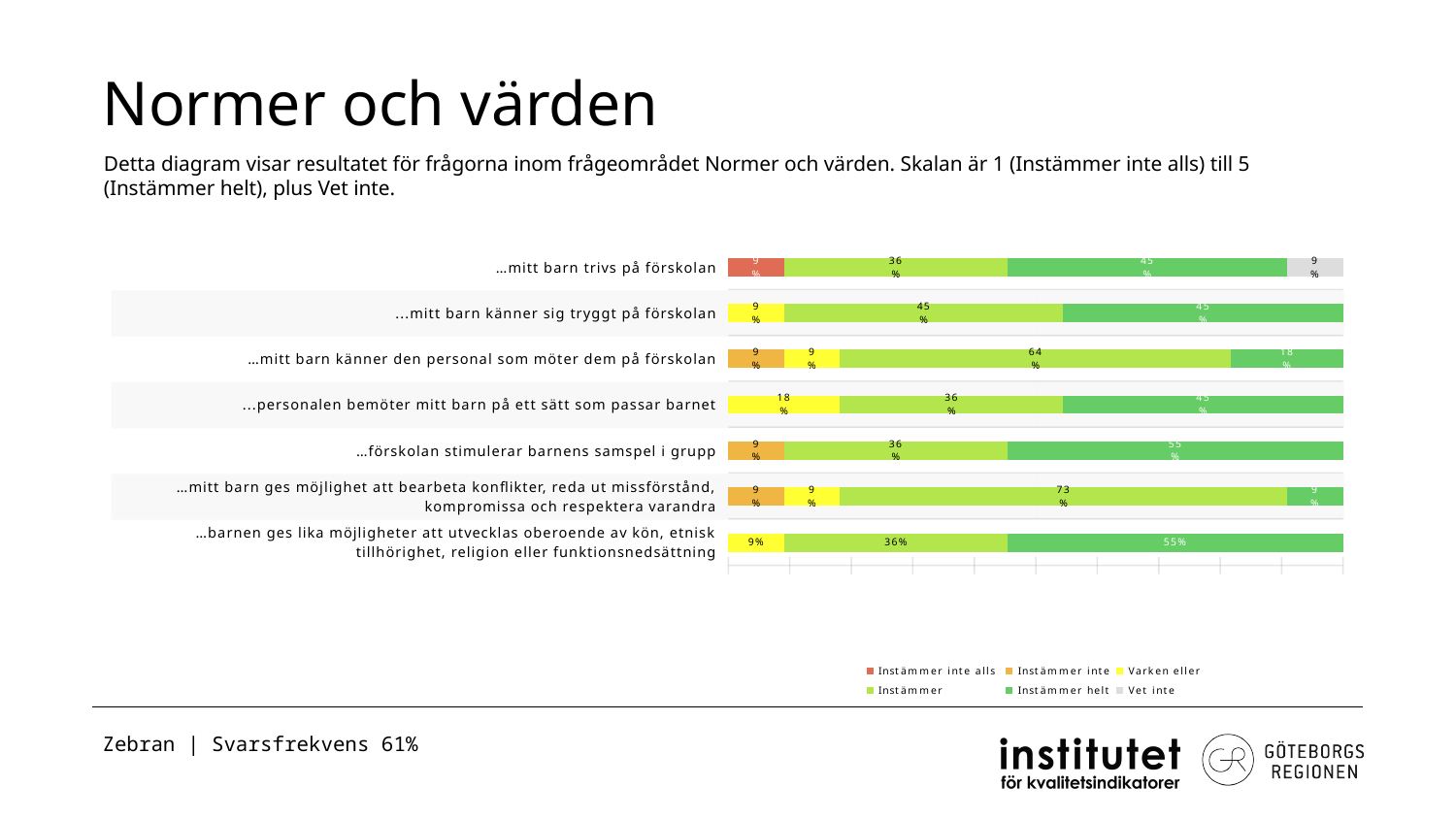
What is the difference between the 'Instämmer' value for '…mitt barn känner den personal som möter dem på förskolan' and the 'Instämmer' value for '…mitt barn trivs på förskolan'? 28% Which is larger: the 'Instämmer helt' value for '…förskolan stimulerar barnens samspel i grupp' or for '…mitt barn trivs på förskolan'? …förskolan stimulerar barnens samspel i grupp How many series does the legend list? 6 What type of chart is shown on the slide? Stacked bar chart What is the 'Instämmer helt' value for '…mitt barn känner den personal som möter dem på förskolan'? 18% What is the 'Vet inte' value for '…mitt barn trivs på förskolan'? 9% Which question has the highest 'Instämmer' value? …mitt barn ges möjlighet att bearbeta konflikter, reda ut missförstånd, kompromissa och respektera varandra What is the 'Varken eller' value for '…personalen bemöter mitt barn på ett sätt som passar barnet'? 18% What is the total of the stacked bar for '…förskolan stimulerar barnens samspel i grupp'? 100% Which colour represents 'Instämmer inte alls' in the legend? Red What is the 'Instämmer' value for '…mitt barn ges möjlighet att bearbeta konflikter, reda ut missförstånd, kompromissa och respektera varandra'? 73% How many questions (categories) are plotted in the chart? 7